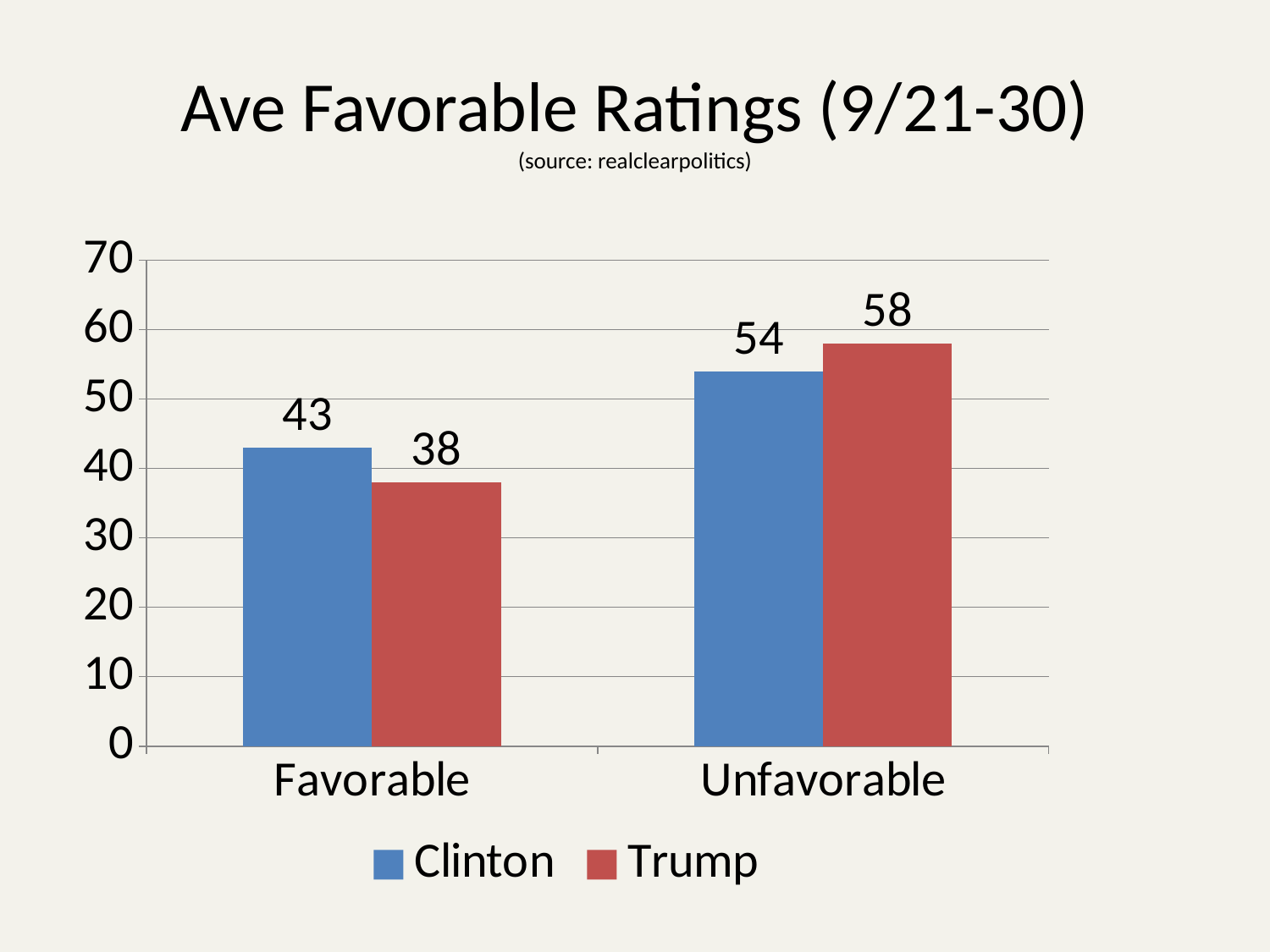
What is Clinton's Favorable rating? 43 What is the difference between Trump's and Clinton's Unfavorable ratings? 4 What kind of chart is shown on the slide? Bar chart What is Clinton's Unfavorable rating? 54 What is the difference between Clinton's and Trump's Favorable ratings? 5 Which bar has the highest value on the chart? Trump, Unfavorable Who has the higher Unfavorable rating, Clinton or Trump? Trump What is Trump's Unfavorable rating? 58 What is the title of the chart? Ave Favorable Ratings (9/21-30) How many series does the legend list? 2 Which bar has the lowest value on the chart? Trump, Favorable What is Trump's Favorable rating? 38